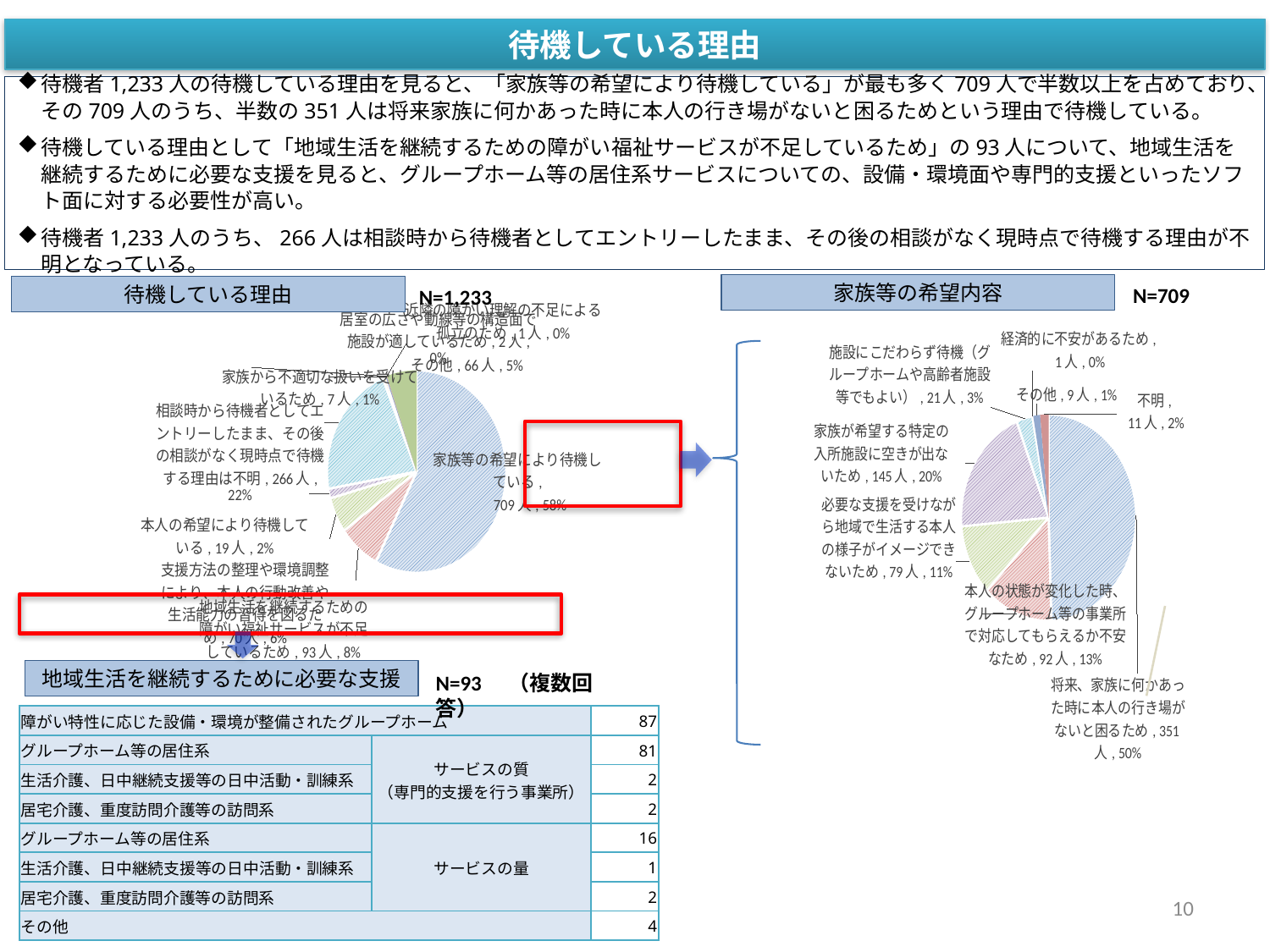
「待機している理由」のグラフで、「その他」の人数は何人ですか？ 66人 「待機している理由」のグラフはどの種類のグラフですか？ 円グラフ 「家族等の希望内容」のグラフで、「本人の状態が変化した時、グループホーム等の事業所で対応してもらえるか不安なため」と「必要な支援を受けながら地域で生活する本人の様子がイメージできないため」では、どちらの人数が多いですか？ 本人の状態が変化した時、グループホーム等の事業所で対応してもらえるか不安なため 「家族等の希望内容」のグラフで、「家族が希望する特定の入所施設に空きが出ないため」の割合は何％ですか？ 20% 「待機している理由」のグラフで、「家族等の希望により待機している」の人数は何人ですか？ 709人 「待機している理由」のグラフで、「本人の希望により待機している」の人数は何人ですか？ 19人 「家族等の希望内容」のグラフで、「家族が希望する特定の入所施設に空きが出ないため」と「必要な支援を受けながら地域で生活する本人の様子がイメージできないため」の人数の差は何人ですか？ 66人 「待機している理由」のグラフのNはいくつですか？ N=1,233 「家族等の希望内容」のグラフで、「将来、家族に何かあった時に本人の行き場がないと困るため」の人数は何人ですか？ 351人 「待機している理由」のグラフで、最も人数が多い理由はどれですか？ 家族等の希望により待機している 「家族等の希望内容」のグラフで、「不明」の人数は何人ですか？ 11人 「待機している理由」のグラフで、「家族等の希望により待機している」の割合は何％ですか？ 58%